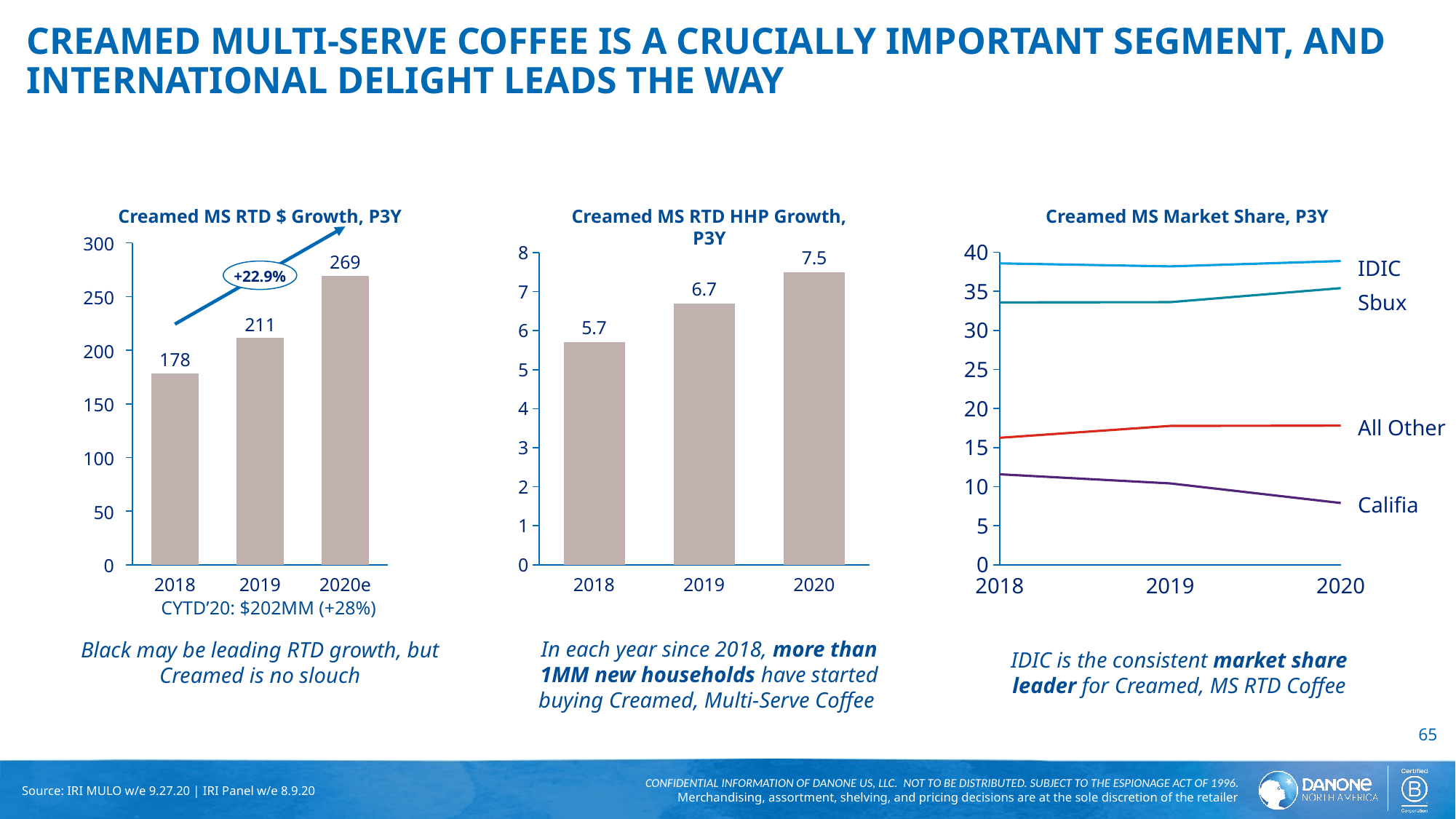
In the 'Creamed MS RTD HHP Growth, P3Y' chart, what is the difference between the 2020 and 2019 values? 0.8 In the 'Creamed MS Market Share, P3Y' chart, how many series are plotted? 4 In the 'Creamed MS RTD $ Growth, P3Y' chart, what is the difference between the 2020e and 2018 values? 91 In the 'Creamed MS RTD $ Growth, P3Y' chart, which year has the highest value? 2020e In the 'Creamed MS Market Share, P3Y' chart, which series has the highest value in 2020, IDIC or Sbux? IDIC In the 'Creamed MS RTD HHP Growth, P3Y' chart, what is the value for 2018? 5.7 In the 'Creamed MS RTD $ Growth, P3Y' chart, what growth percentage is shown in the callout? +22.9% In the 'Creamed MS RTD $ Growth, P3Y' chart, what is the value for 2019? 211 What kind of chart is the 'Creamed MS Market Share, P3Y' chart? line chart In the 'Creamed MS RTD HHP Growth, P3Y' chart, which year has the lowest value? 2018 In the 'Creamed MS RTD HHP Growth, P3Y' chart, do the values rise or fall from 2018 to 2020? rise In the 'Creamed MS Market Share, P3Y' chart, is the value for Califia in 2020 greater or less than 10? less